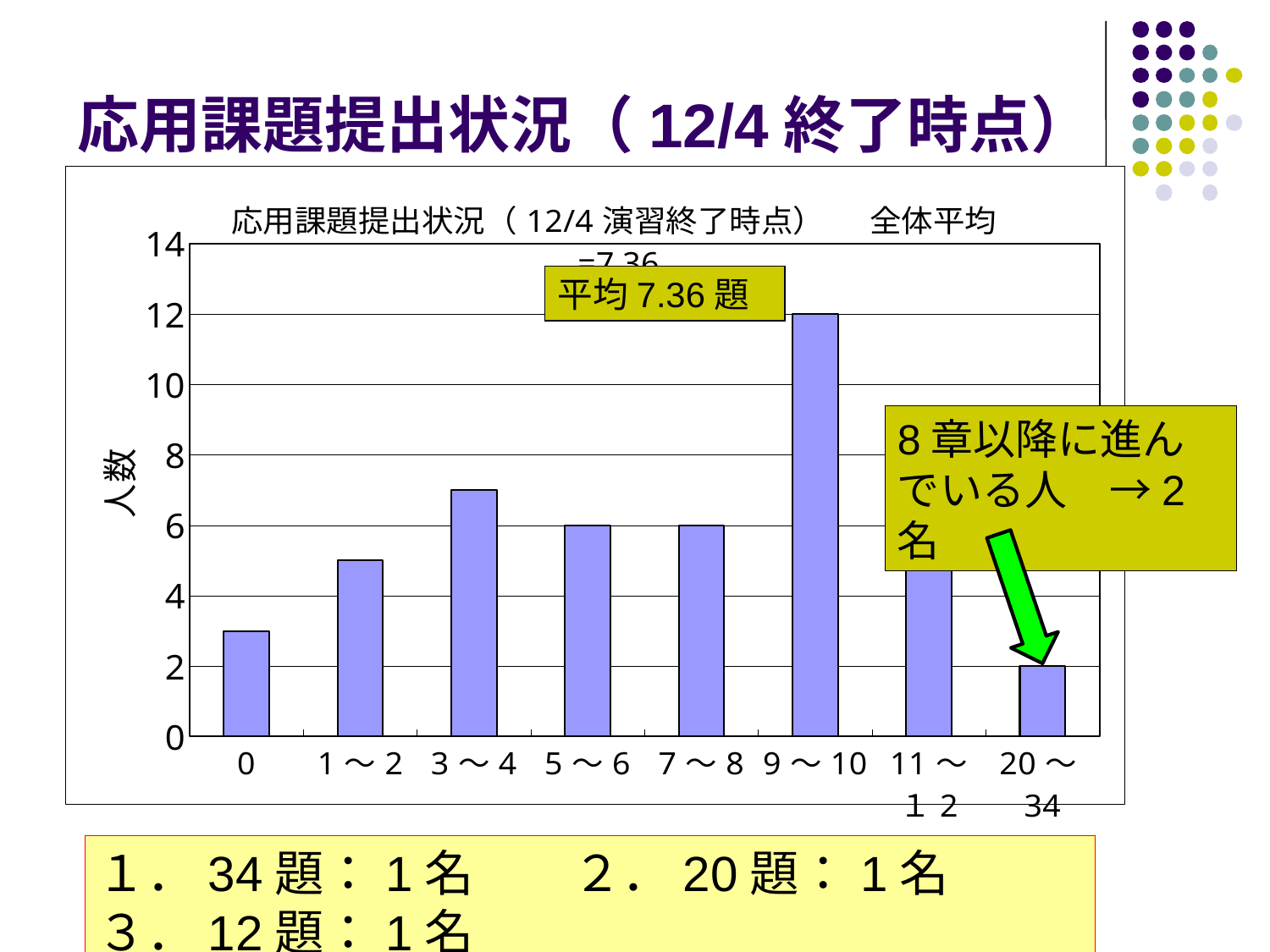
Which category has the lowest value in the chart? 20～34 How many categories are shown on the x axis of the chart? 8 Is the value for the 0 category greater or less than 4? less What is the value for the 9～10 category? 12 What kind of chart is shown on the slide? bar chart Is the value for the 3～4 category greater or less than 6? greater What is the label on the y axis of the chart? 人数 What is the difference between the values for 9～10 and 20～34? 10 Which is larger, the value for 9～10 or the value for 3～4? 9～10 What is the value for the 20～34 category? 2 Which category has the highest value in the chart? 9～10 What is the value for the 5～6 category? 6